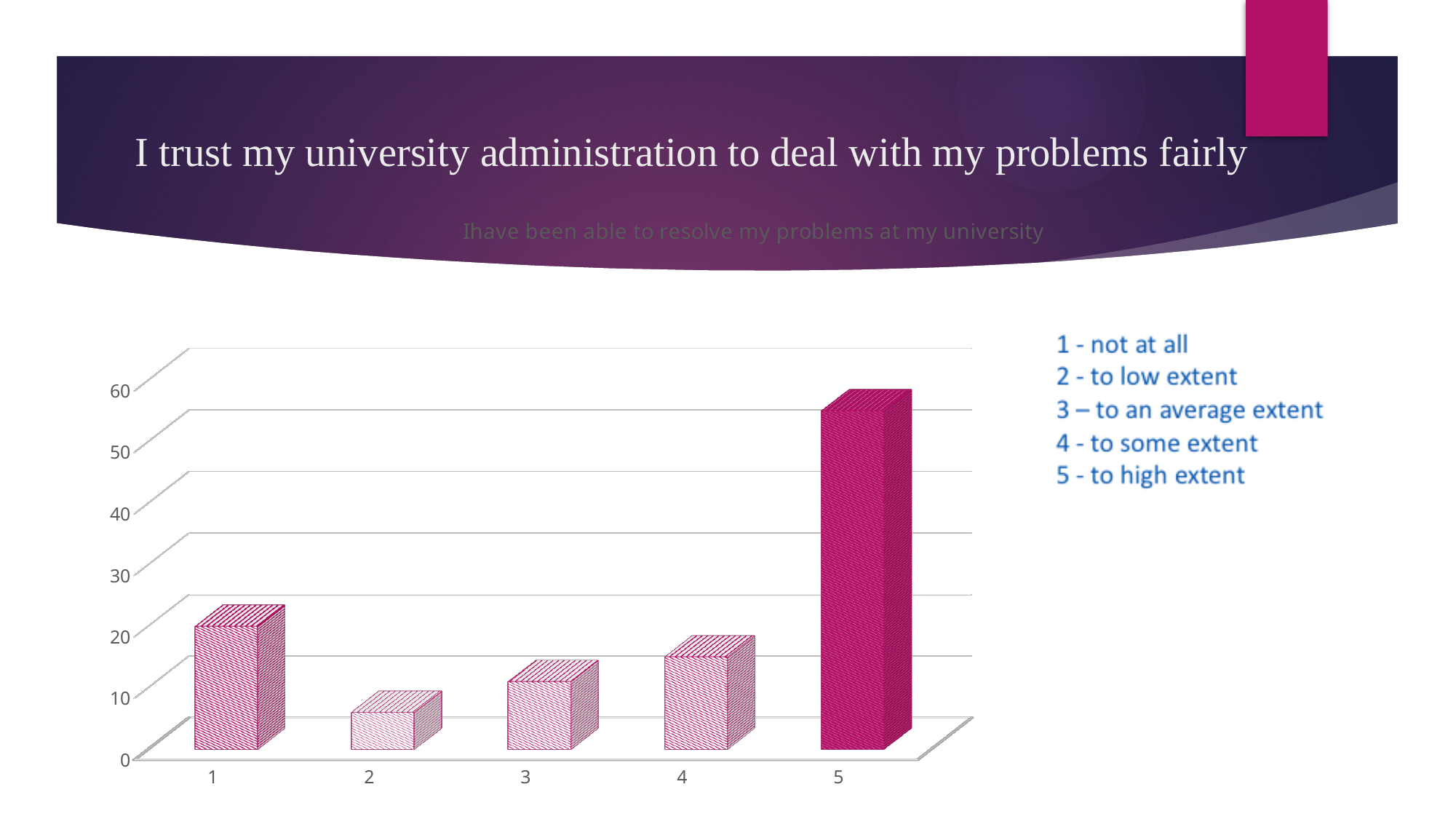
Is the value for category 5 greater or less than 50? greater What is the title of the slide containing the chart? I trust my university administration to deal with my problems fairly Which category has the highest bar? 5 Is the value for category 4 greater or less than 20? less What kind of chart is shown on the slide? bar chart Is the value for category 2 greater or less than 10? less How many categories are plotted on the x axis? 5 Which is larger, the value for category 1 or the value for category 4? 1 According to the key on the slide, what does a rating of 5 mean? to high extent Which is larger, the value for category 3 or the value for category 2? 3 Which category has the lowest bar? 2